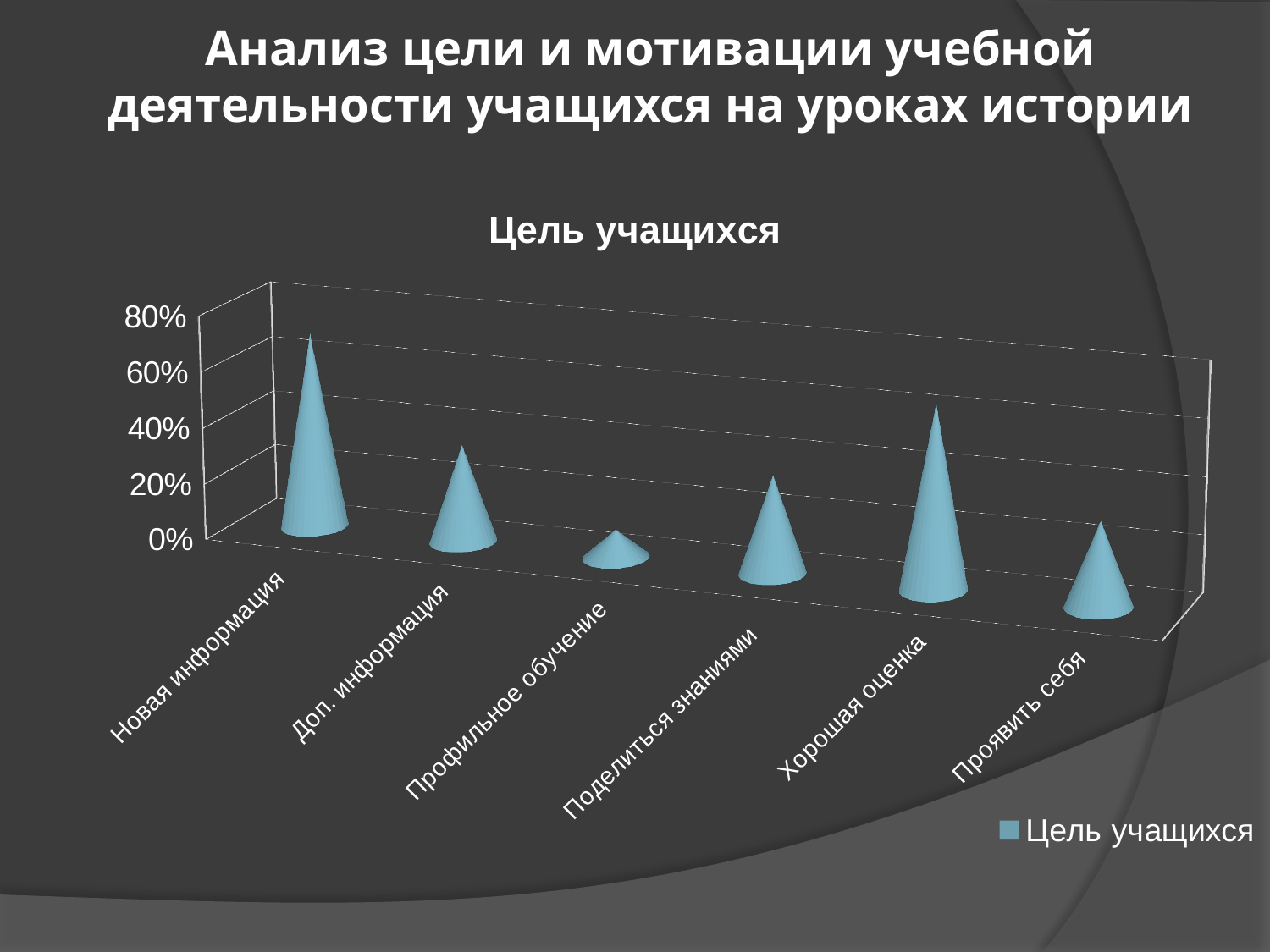
Which is larger, the value for Доп. информация or the value for Профильное обучение? Доп. информация Is the value for Профильное обучение greater or less than 20%? less What is the title of the chart? Цель учащихся Is the value for Хорошая оценка greater or less than 20%? greater What kind of chart is shown on the slide? bar chart Is the value for Новая информация greater or less than 40%? greater Which is larger, the value for Новая информация or the value for Поделиться знаниями? Новая информация How many series does the legend list? 1 Which is larger, the value for Хорошая оценка or the value for Проявить себя? Хорошая оценка What is the name of the series listed in the legend? Цель учащихся How many categories are shown on the x axis of the chart? 6 Which category has the lowest value in the chart? Профильное обучение